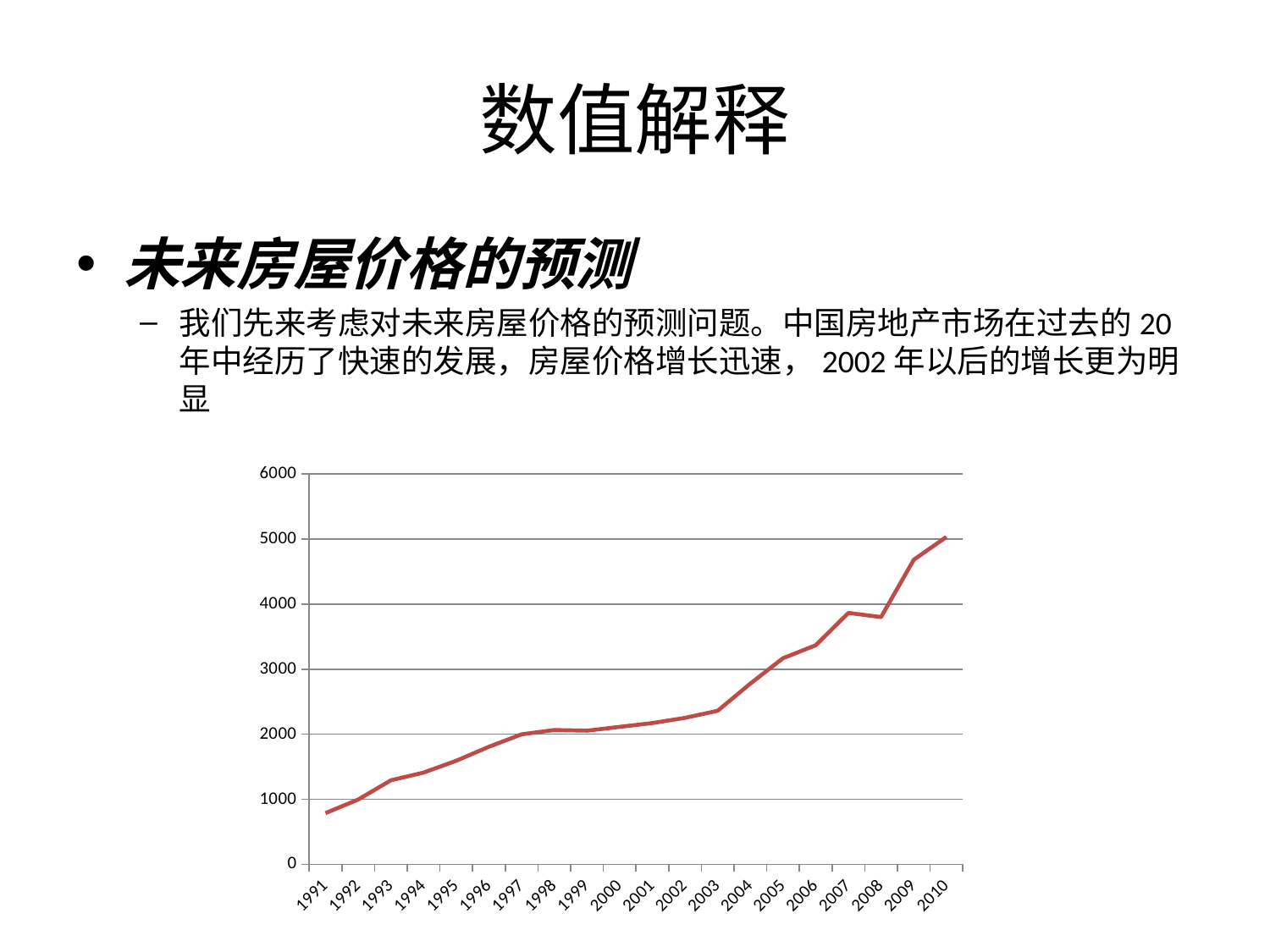
Which year has the lowest value in the chart? 1991 Is the value for 2009 greater or less than 4000? greater Is the value for 2010 greater or less than 4000? greater Is the value for 2004 greater or less than 3000? less Do the values in the chart generally rise or fall from 1991 to 2010? rise Which year has the larger value, 2003 or 2009? 2009 What kind of chart is shown on the slide? line chart Which year has the highest value in the chart? 2010 How many years are plotted along the x axis of the chart? 20 What is the highest value shown on the y axis of the chart? 6000 Which year has the larger value, 2005 or 2000? 2005